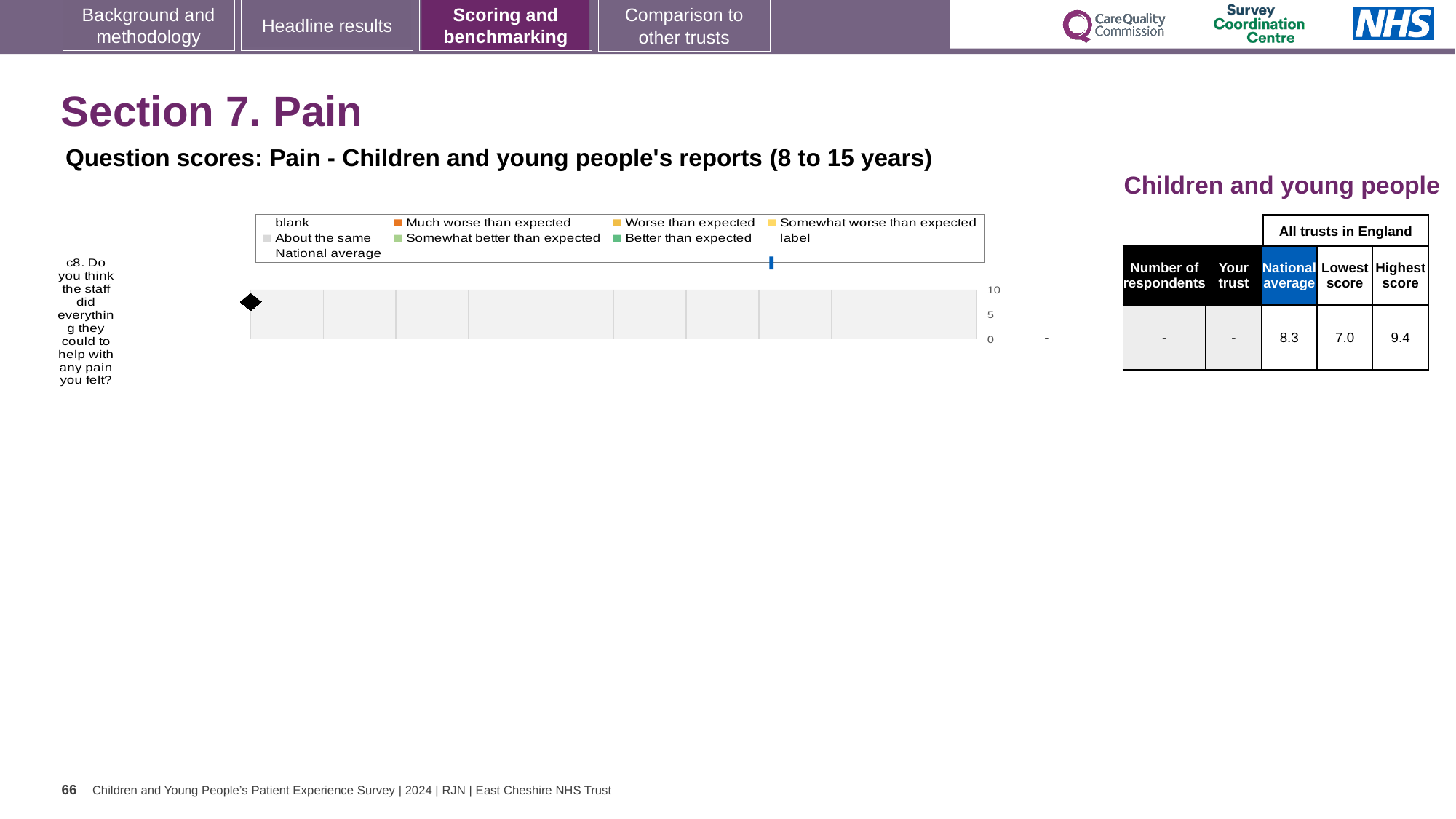
What value is shown for 'Your trust' for question c8 in the table? - What kind of chart is shown for question c8 on the slide? bar chart In the table next to the chart, what is the lowest score among all trusts in England for question c8? 7.0 What is the maximum value shown on the chart's score axis? 10 In the table next to the chart, what is the national average score for question c8? 8.3 What is the difference between the highest score (9.4) and the lowest score (7.0) shown in the table for question c8? 2.4 How many questions (categories) are plotted on the chart? 1 In the table next to the chart, what is the highest score among all trusts in England for question c8? 9.4 Which legend entry is shown with an orange marker? Much worse than expected Is the national average score for question c8 greater or less than 5? greater Which is larger for question c8: the national average or the highest score? Highest score